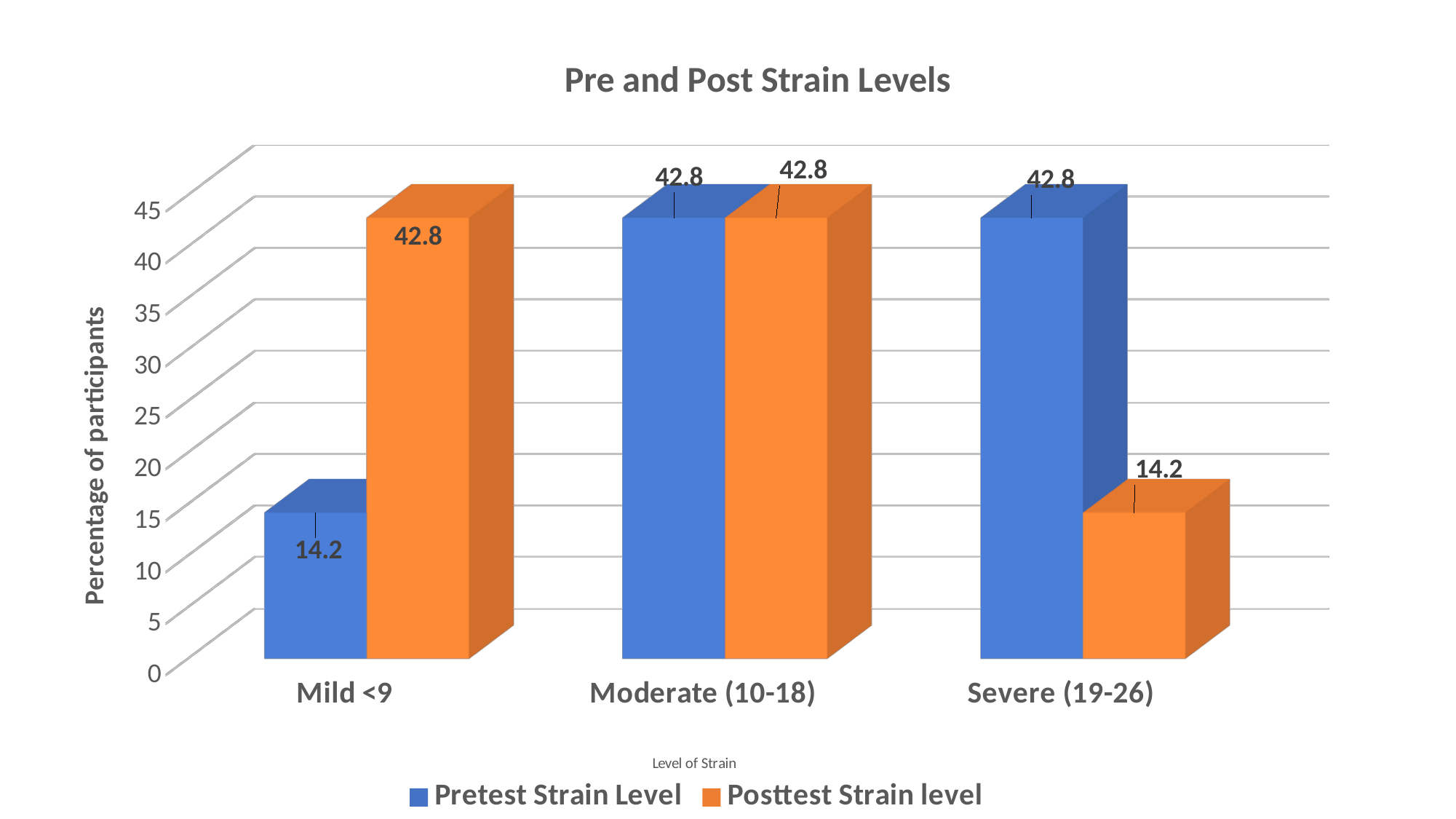
What kind of chart is shown? Bar chart What is the Posttest Strain level value for Severe (19-26)? 14.2 For Severe (19-26), which is larger: the Pretest Strain Level or the Posttest Strain level? Pretest Strain Level What is the Posttest Strain level value for Mild <9? 42.8 What is the difference between the Posttest and Pretest values for Mild <9? 28.6 What is the title of the chart? Pre and Post Strain Levels Which category has the lowest Pretest Strain Level value? Mild <9 What is the Pretest Strain Level value for Mild <9? 14.2 What is the Pretest Strain Level value for Moderate (10-18)? 42.8 How many series does the legend list? 2 How many categories are shown on the x axis? 3 Which category has the lowest Posttest Strain level value? Severe (19-26)